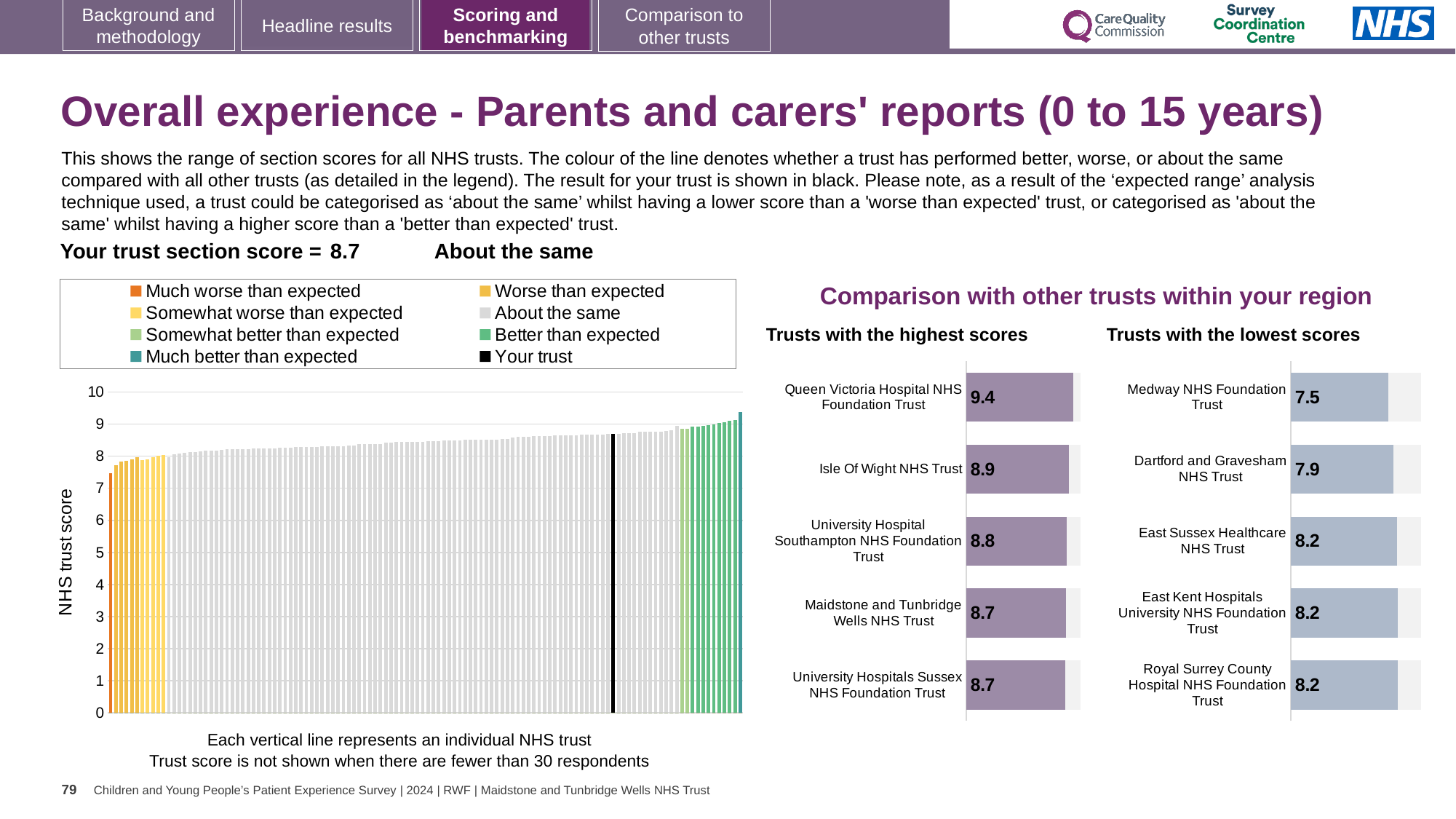
In the 'Trusts with the lowest scores' chart, what is the score for Dartford and Gravesham NHS Trust? 7.9 In the main chart on the left, what is the section score for your trust? 8.7 Which is larger: the score for Isle Of Wight NHS Trust in the highest scores chart or the score for Dartford and Gravesham NHS Trust in the lowest scores chart? Isle Of Wight NHS Trust How many entries does the legend of the main chart on the left list? 8 What kind of chart is the main chart on the left showing NHS trust scores? Bar chart In the main chart on the left, do the trust scores rise or fall from left to right? Rise How many trusts are shown in the 'Trusts with the highest scores' chart? 5 In the 'Trusts with the highest scores' chart, what is the difference between the scores of Queen Victoria Hospital NHS Foundation Trust and Isle Of Wight NHS Trust? 0.5 In the 'Trusts with the highest scores' chart, what is the score for Queen Victoria Hospital NHS Foundation Trust? 9.4 In the 'Trusts with the lowest scores' chart, what is the difference between the scores of East Sussex Healthcare NHS Trust and Medway NHS Foundation Trust? 0.7 In the 'Trusts with the highest scores' chart, what is the score for University Hospital Southampton NHS Foundation Trust? 8.8 In the 'Trusts with the lowest scores' chart, which trust has the lowest score? Medway NHS Foundation Trust